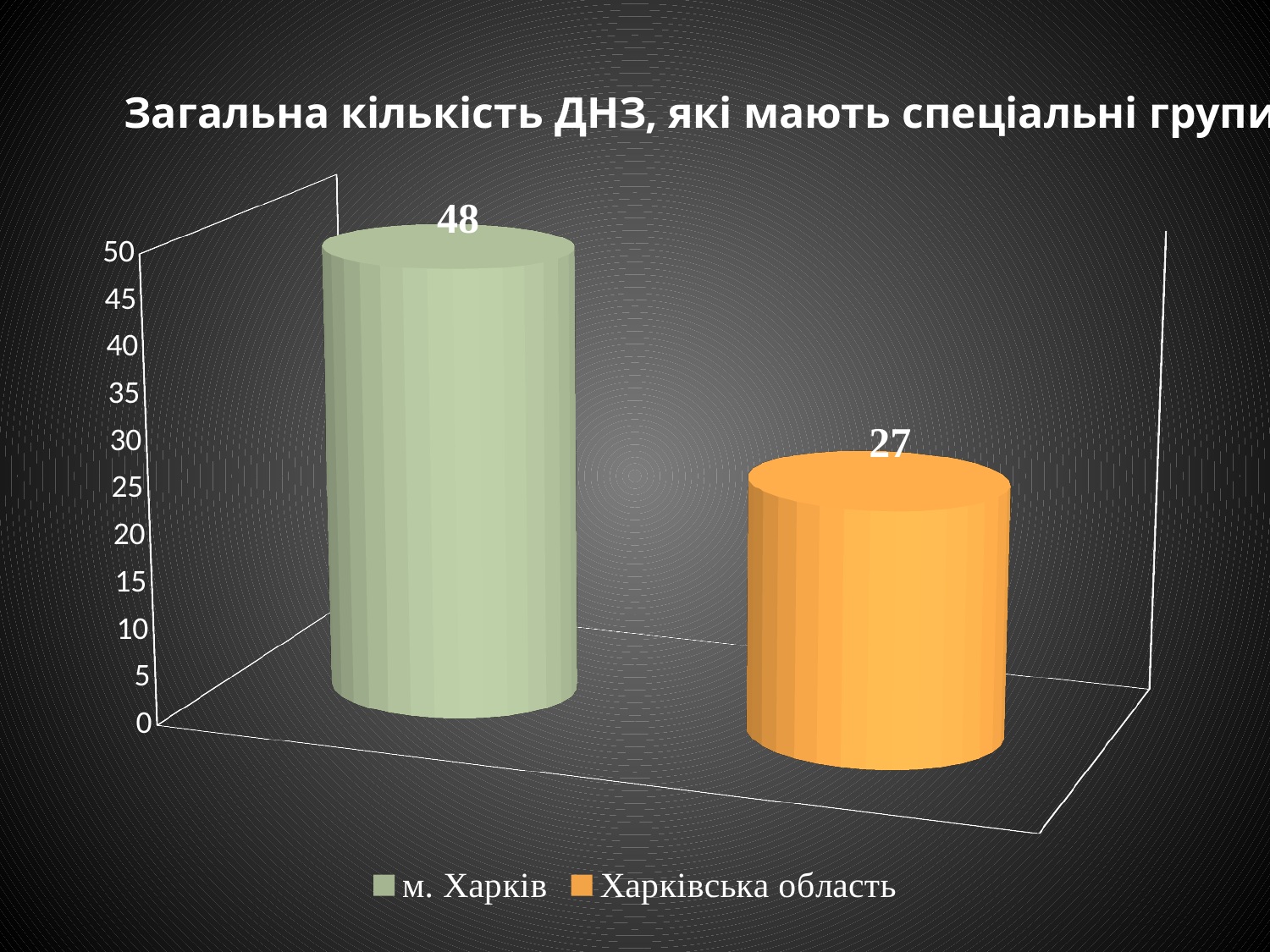
How many bars are plotted on the chart? 2 Which is larger, the value for м. Харків or the value for Харківська область? м. Харків What colour is the bar for Харківська область? orange Which series has the highest value? м. Харків What kind of chart is shown on the slide? bar chart What is the value for Харківська область? 27 How many series does the legend list? 2 What is the difference between the values for м. Харків and Харківська область? 21 Which series has the lowest value? Харківська область What is the value for м. Харків? 48 Is the value for м. Харків greater or less than 40? greater Is the value for Харківська область greater or less than 30? less